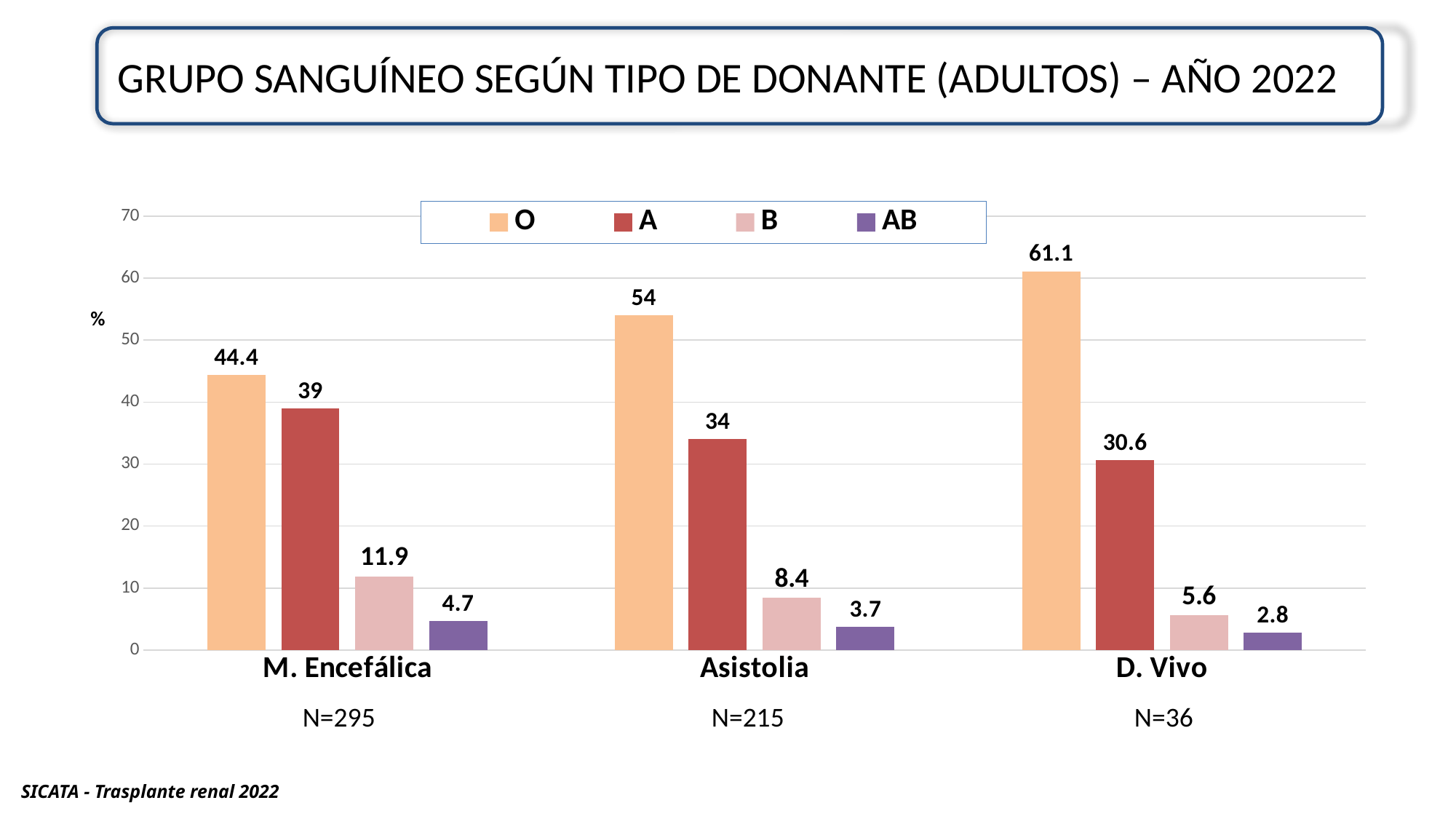
What is the value for blood group O in the M. Encefálica category? 44.4 Which donor type has the highest value for blood group O? D. Vivo Which donor type has the lowest value for blood group B? D. Vivo What is the value for blood group A in the Asistolia category? 34 How many donor type categories are shown on the x axis? 3 What is the value for blood group B in the Asistolia category? 8.4 Which is larger: the value for A in M. Encefálica or the value for A in Asistolia? A in M. Encefálica What is the difference between the O and A values in the D. Vivo category? 30.5 What is the value for blood group AB in the D. Vivo category? 2.8 What is the N value shown under the Asistolia category? N=215 How many series does the legend list? 4 What kind of chart is shown on the slide? Bar chart